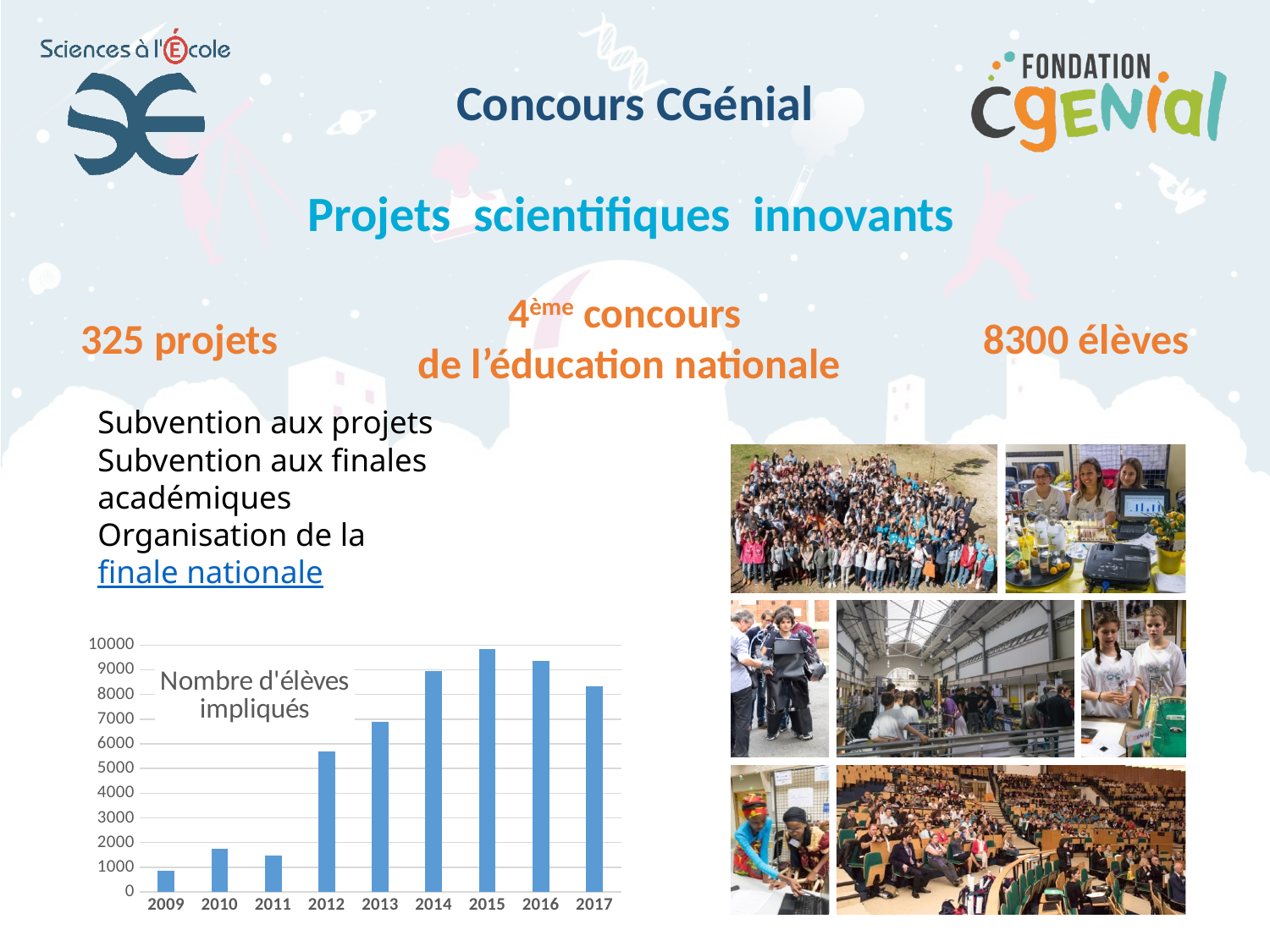
How many years are shown on the x axis of the chart? 9 Which year has the larger value, 2010 or 2011? 2010 What is the title of the chart? Nombre d'élèves impliqués Is the value for 2017 greater or less than 8000? greater What kind of chart is shown on the slide? bar chart Which year has the highest number of students involved? 2015 Do the values rise or fall from 2009 to 2015? rise Which year has the lowest number of students involved? 2009 Which year has the larger value, 2014 or 2017? 2014 Is the value for 2012 greater or less than 5000? greater